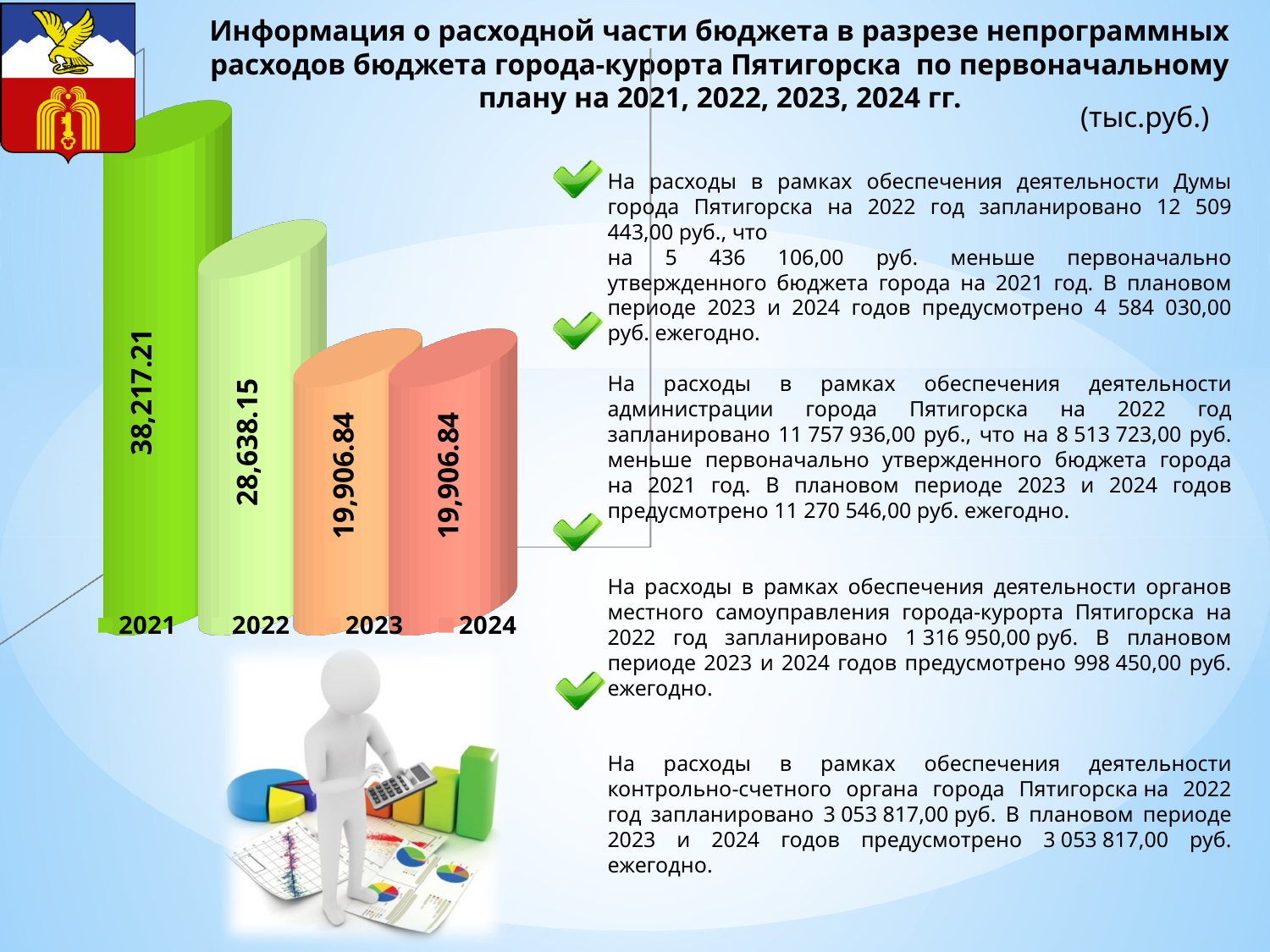
What unit is stated for the values on the chart? тыс.руб. Which year has the highest value on the bar chart? 2021 Which is larger on the bar chart, the value for 2022 or the value for 2023? 2022 What kind of chart is shown on the slide? Bar chart How many years (bars) are shown on the bar chart? 4 What is the value shown for 2023 on the bar chart? 19,906.84 What is the value shown for 2024 on the bar chart? 19,906.84 What is the value shown for 2022 on the bar chart? 28,638.15 What is the value shown for 2021 on the bar chart? 38,217.21 What is the difference between the values for 2021 and 2022 on the bar chart? 9,579.06 Do the values on the bar chart rise or fall from 2021 to 2023? Fall What is the difference between the values for 2022 and 2023 on the bar chart? 8,731.31